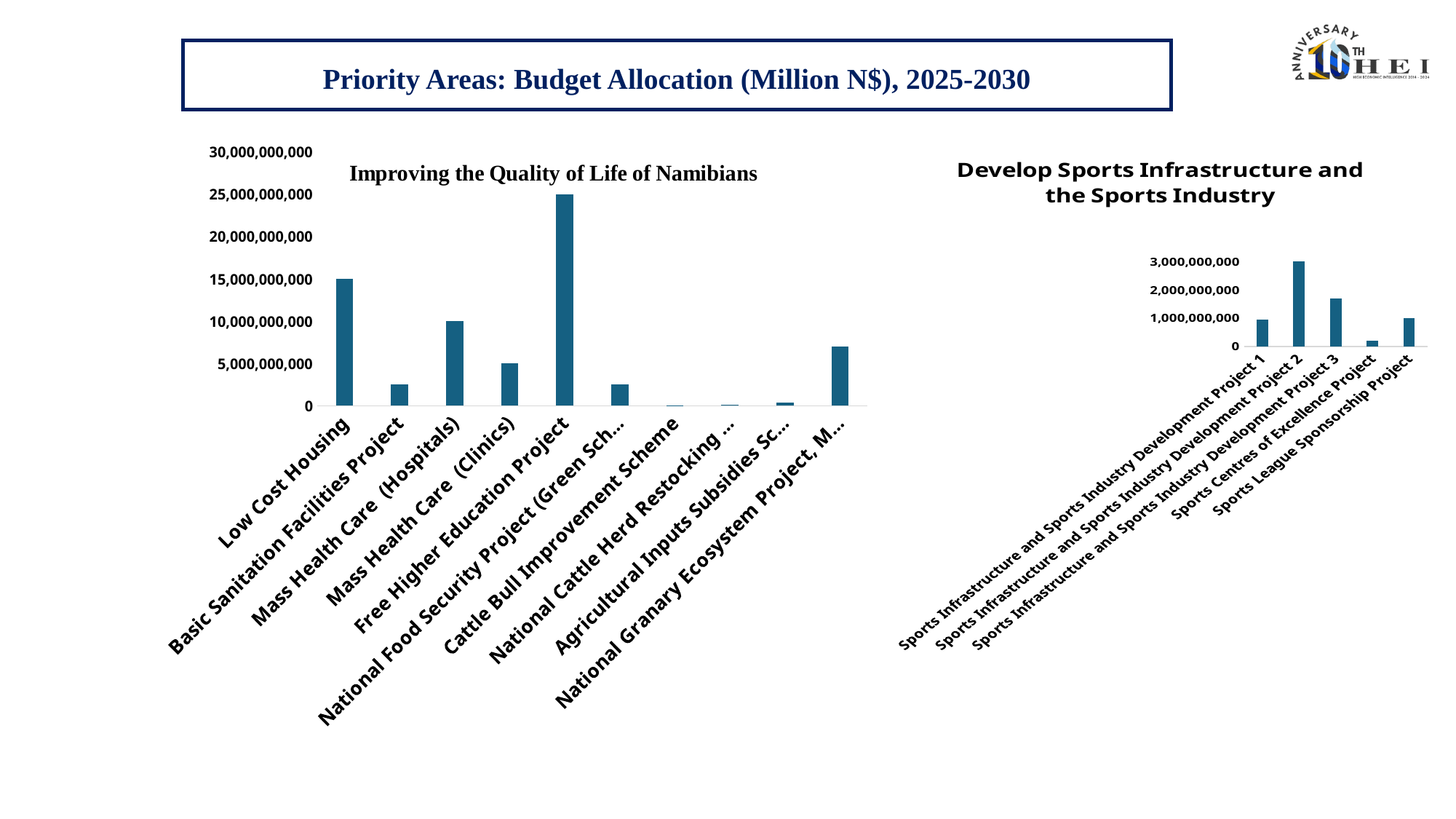
What type of chart is the 'Develop Sports Infrastructure and the Sports Industry' chart? Bar chart In the 'Develop Sports Infrastructure and the Sports Industry' chart, which category has the lowest value? Sports Centres of Excellence Project In the 'Improving the Quality of Life of Namibians' chart, which is larger: Low Cost Housing or Mass Health Care (Hospitals)? Low Cost Housing In the 'Improving the Quality of Life of Namibians' chart, what is the budget allocation for the Free Higher Education Project? 25,000,000,000 In the 'Improving the Quality of Life of Namibians' chart, how many categories are shown on the x axis? 10 In the 'Improving the Quality of Life of Namibians' chart, what is the difference between the Free Higher Education Project and Low Cost Housing? 10,000,000,000 In the 'Improving the Quality of Life of Namibians' chart, is the value for Mass Health Care (Clinics) greater or less than 10,000,000,000? less In the 'Improving the Quality of Life of Namibians' chart, which category has the highest budget allocation? Free Higher Education Project In the 'Develop Sports Infrastructure and the Sports Industry' chart, how many categories are shown? 5 In the 'Improving the Quality of Life of Namibians' chart, what is the value for Low Cost Housing? 15,000,000,000 In the 'Improving the Quality of Life of Namibians' chart, what is the value for Mass Health Care (Hospitals)? 10,000,000,000